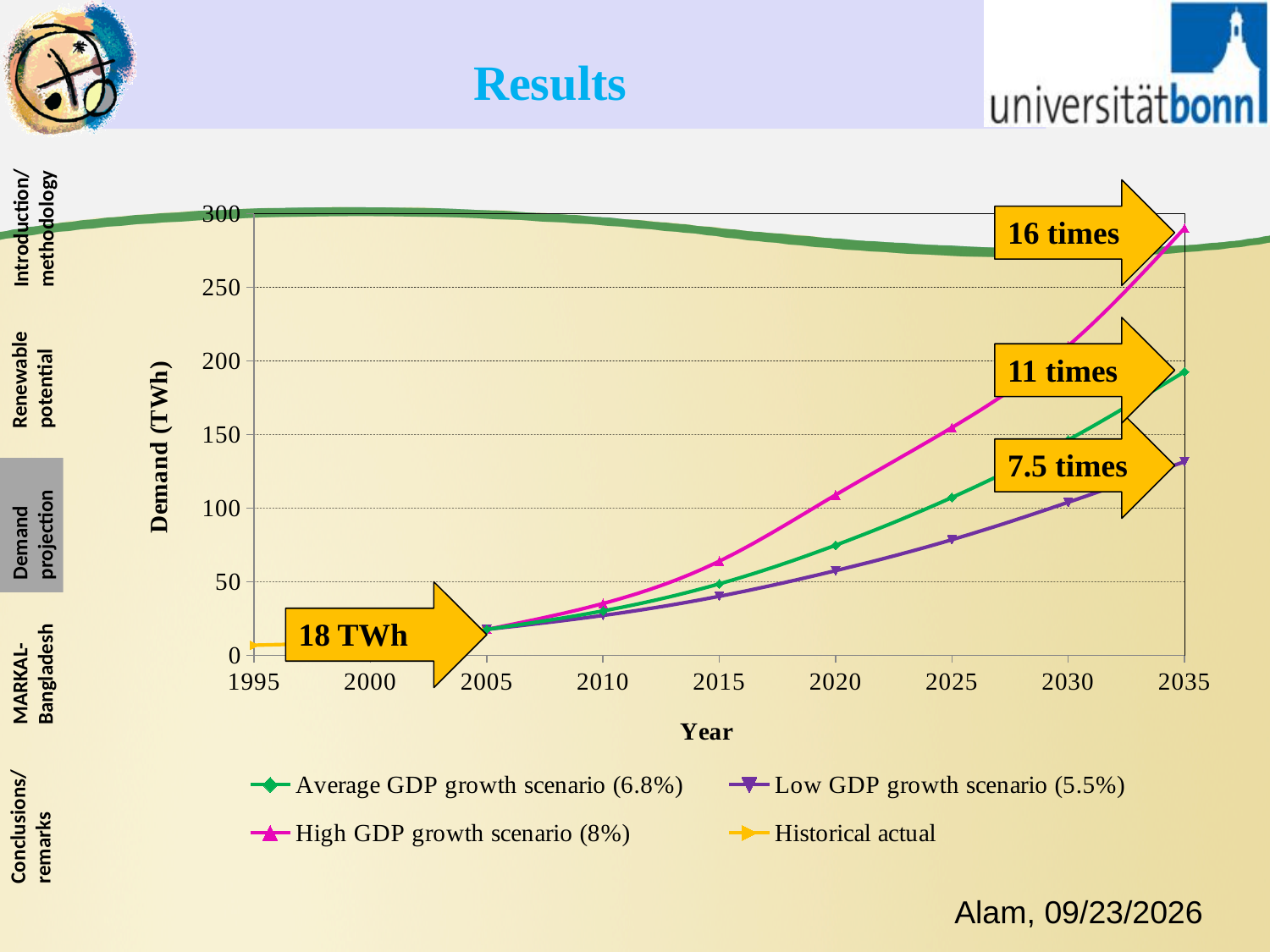
What is the title of the horizontal axis? Year Does the Average GDP growth scenario (6.8%) rise or fall from 2005 to 2035? rise Is the value for the High GDP growth scenario (8%) in 2015 greater or less than 50? greater Is the value for the Low GDP growth scenario (5.5%) in 2035 greater or less than 150? less Is the value for the Average GDP growth scenario (6.8%) in 2035 greater or less than 150? greater What is the title of the vertical axis? Demand (TWh) What demand value does the arrow annotation give for 2005? 18 TWh In 2035, which is larger: the High GDP growth scenario (8%) or the Low GDP growth scenario (5.5%)? High GDP growth scenario (8%) How many series does the chart legend list? 4 Which scenario has the highest demand in 2035? High GDP growth scenario (8%) What type of chart is shown on the slide? line chart